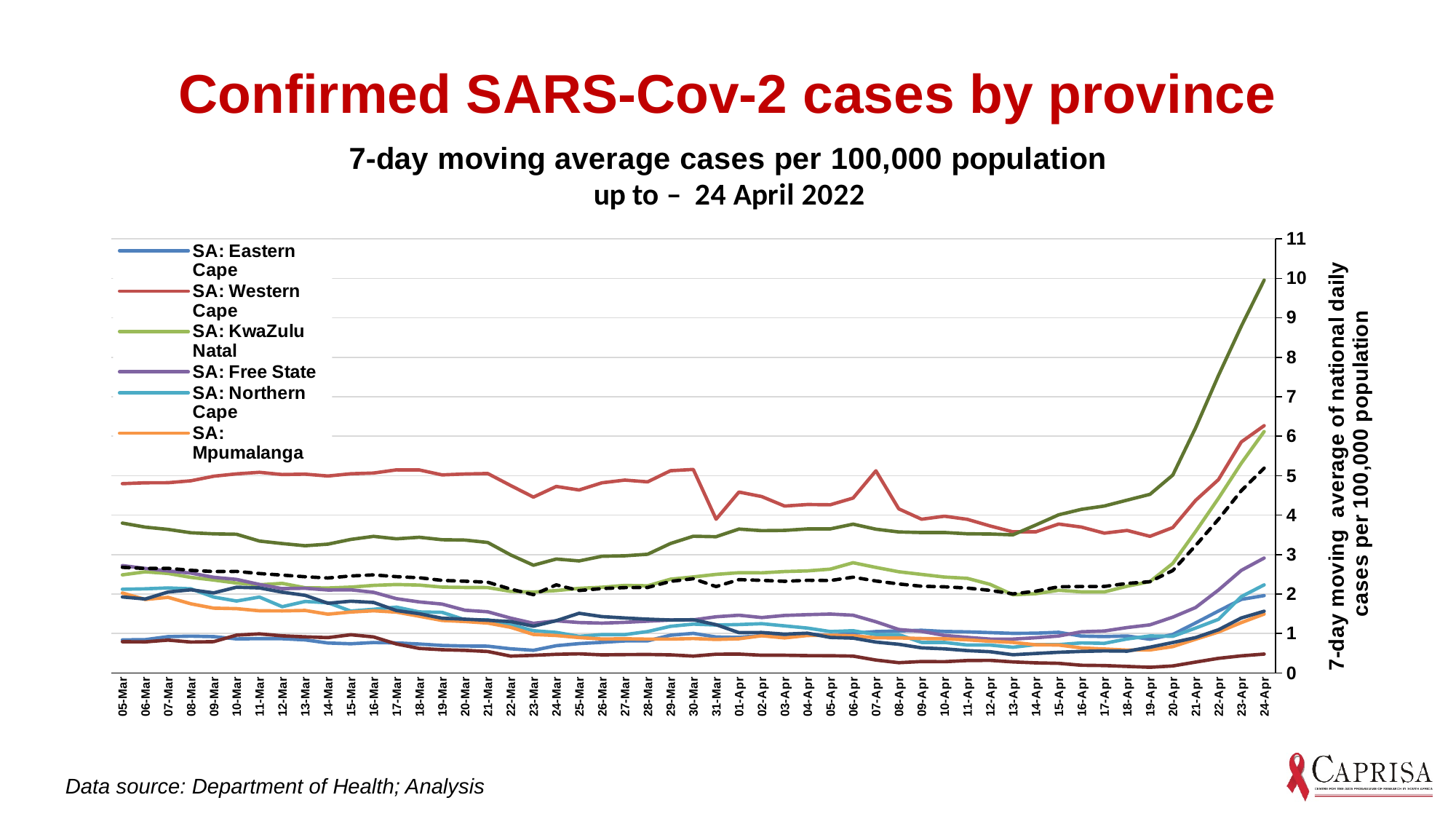
Does the SA: Western Cape line generally rise or fall between 05-Mar and 13-Apr? Fall What is the title of the slide's chart? Confirmed SARS-Cov-2 cases by province On 24-Apr, which is larger: the value for SA: Western Cape or SA: Mpumalanga? SA: Western Cape Does the SA: KwaZulu Natal line rise or fall between 19-Apr and 24-Apr? Rise Is the value for SA: KwaZulu Natal on 24-Apr greater or less than 5? greater Is the value for SA: Western Cape on 05-Mar greater or less than 5? less What is the label on the right-hand vertical axis of the chart? 7-day moving average of national daily cases per 100,000 population Is the value for SA: Free State on 24-Apr greater or less than 2? greater What kind of chart is shown on the slide? Line chart How many series does the chart's legend list? 6